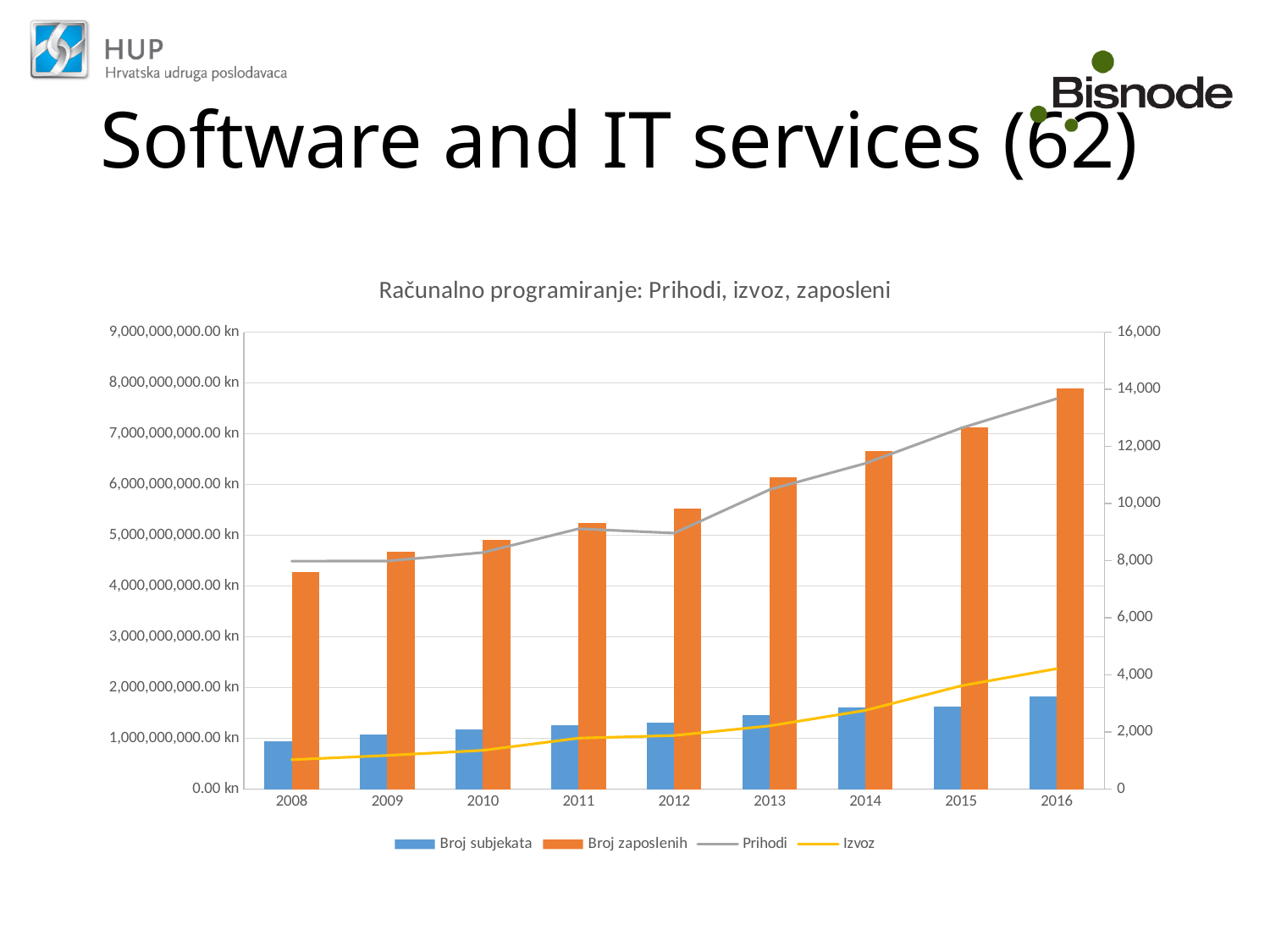
Is the Broj subjekata value for 2016 greater or less than 2,000? greater What is the title of the chart? Računalno programiranje: Prihodi, izvoz, zaposleni Is the Broj zaposlenih value for 2008 greater or less than 8,000? less Is the Broj zaposlenih value for 2015 greater or less than 12,000? greater In which year is Broj zaposlenih lowest? 2008 How many years are shown on the x axis? 9 Does Broj zaposlenih rise or fall from 2008 to 2016? rise In which year is Broj zaposlenih highest? 2016 How many series does the legend list? 4 What kind of chart is this? Combined bar and line chart